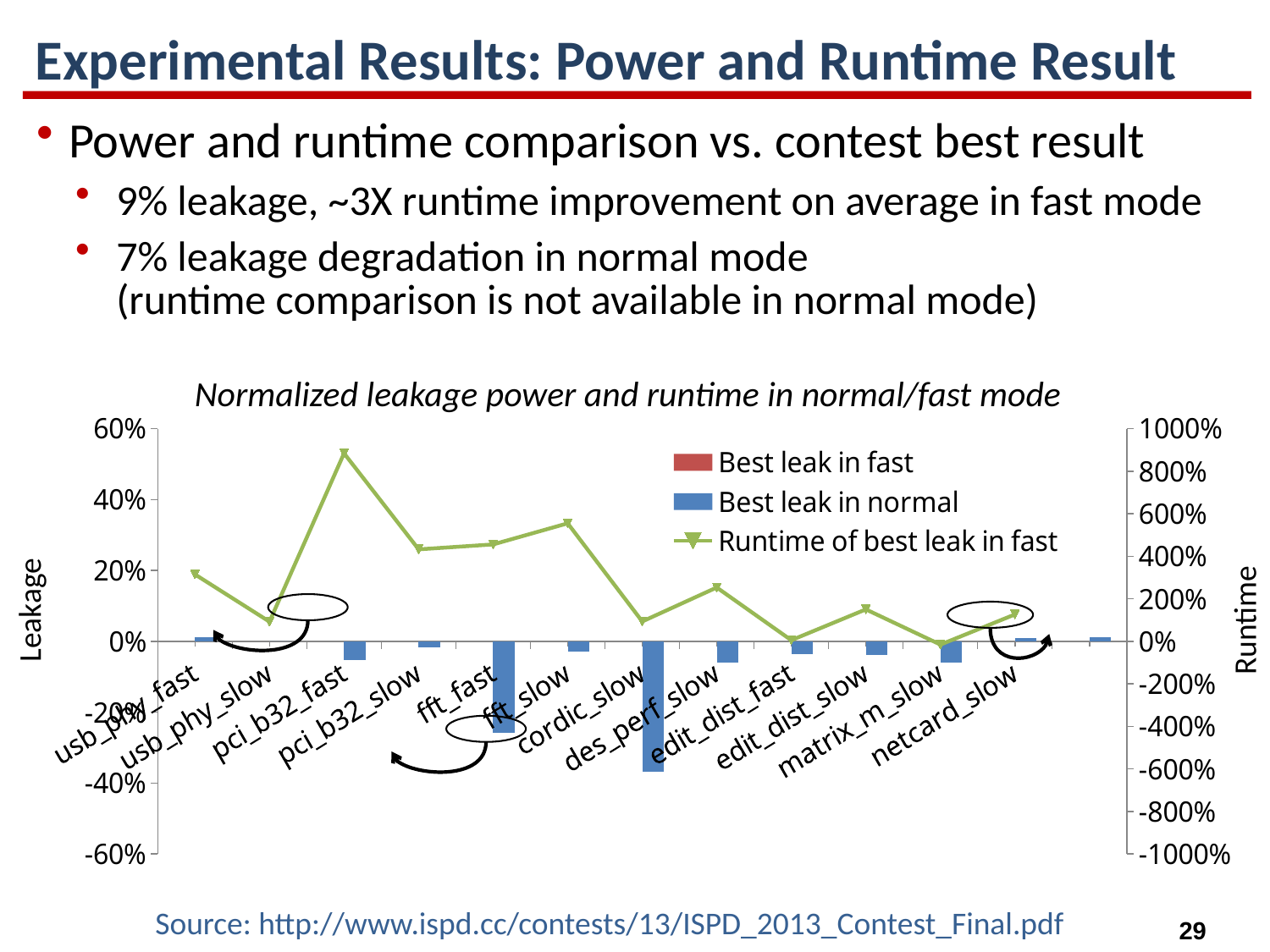
Which has the larger Runtime of best leak in fast value, pci_b32_fast or fft_slow? pci_b32_fast What is the title of the chart? Normalized leakage power and runtime in normal/fast mode What is the label of the left vertical axis of the chart? Leakage How many series does the chart legend list? 3 Is the Runtime of best leak in fast value for cordic_slow greater or less than 200%? less Is the Runtime of best leak in fast value for pci_b32_fast greater or less than 800%? greater Is the Best leak in normal value for des_perf_slow greater or less than -20%? greater Which category has the lowest Best leak in normal bar? cordic_slow How many benchmark categories are shown on the x axis of the chart? 12 What kind of chart is shown on the slide? Combined bar and line chart Which category has the highest value on the Runtime of best leak in fast line? pci_b32_fast